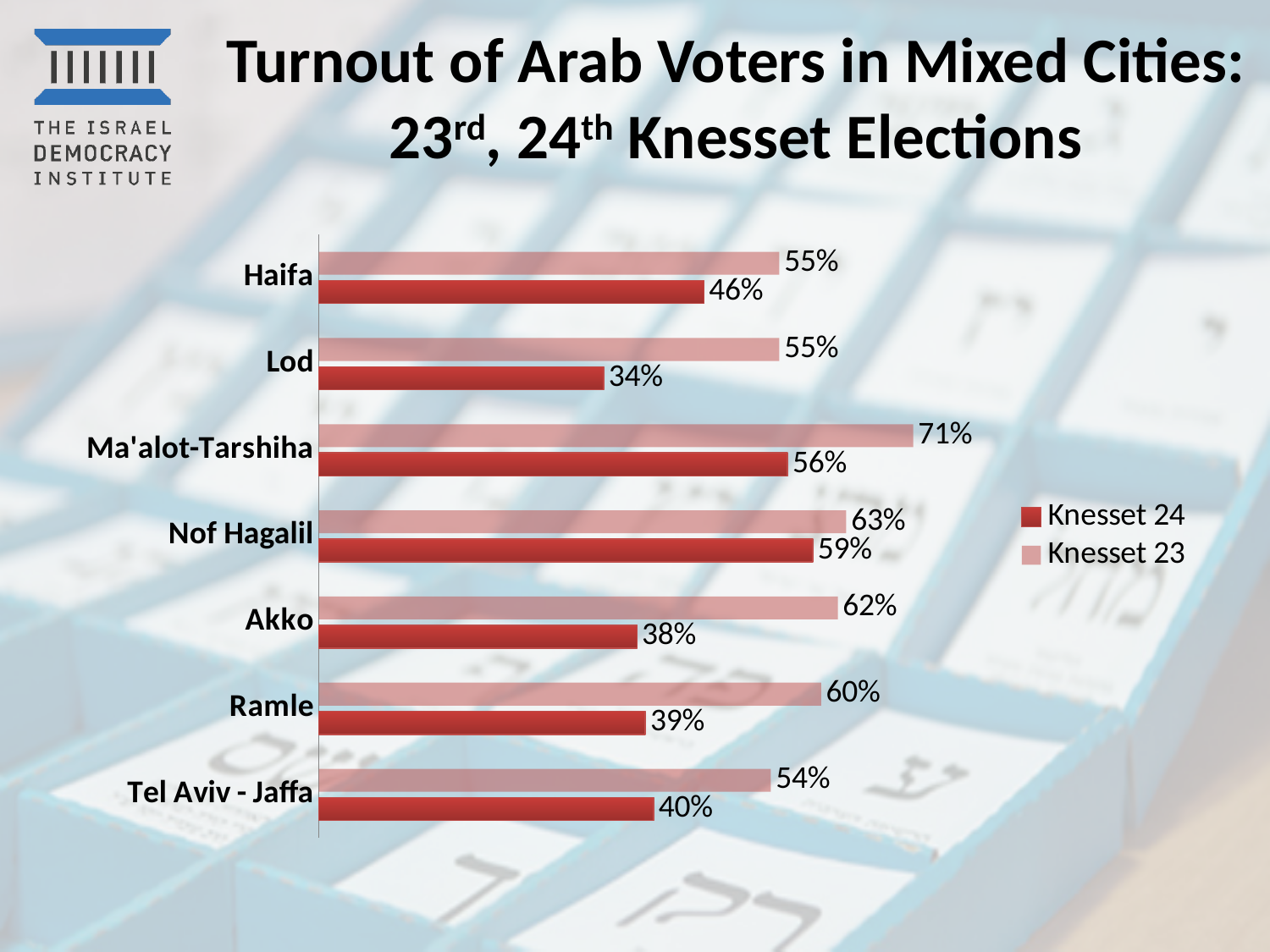
What was the turnout of Arab voters in Lod in the Knesset 24 election? 34% Which series is shown in the darker red colour? Knesset 24 Which city had the lowest turnout in the Knesset 24 election? Lod How many series does the legend list? 2 How many cities are shown in the chart? 7 What was the turnout of Arab voters in Tel Aviv - Jaffa in the Knesset 24 election? 40% Which city had the highest turnout in the Knesset 23 election? Ma'alot-Tarshiha What is the difference between the Knesset 23 and Knesset 24 turnout in Akko? 24% Which is larger: the Knesset 24 turnout in Haifa or in Ramle? Haifa What is the difference between the Knesset 23 and Knesset 24 turnout in Nof Hagalil? 4% What kind of chart is shown on the slide? Bar chart What was the turnout of Arab voters in Akko in the Knesset 23 election? 62%